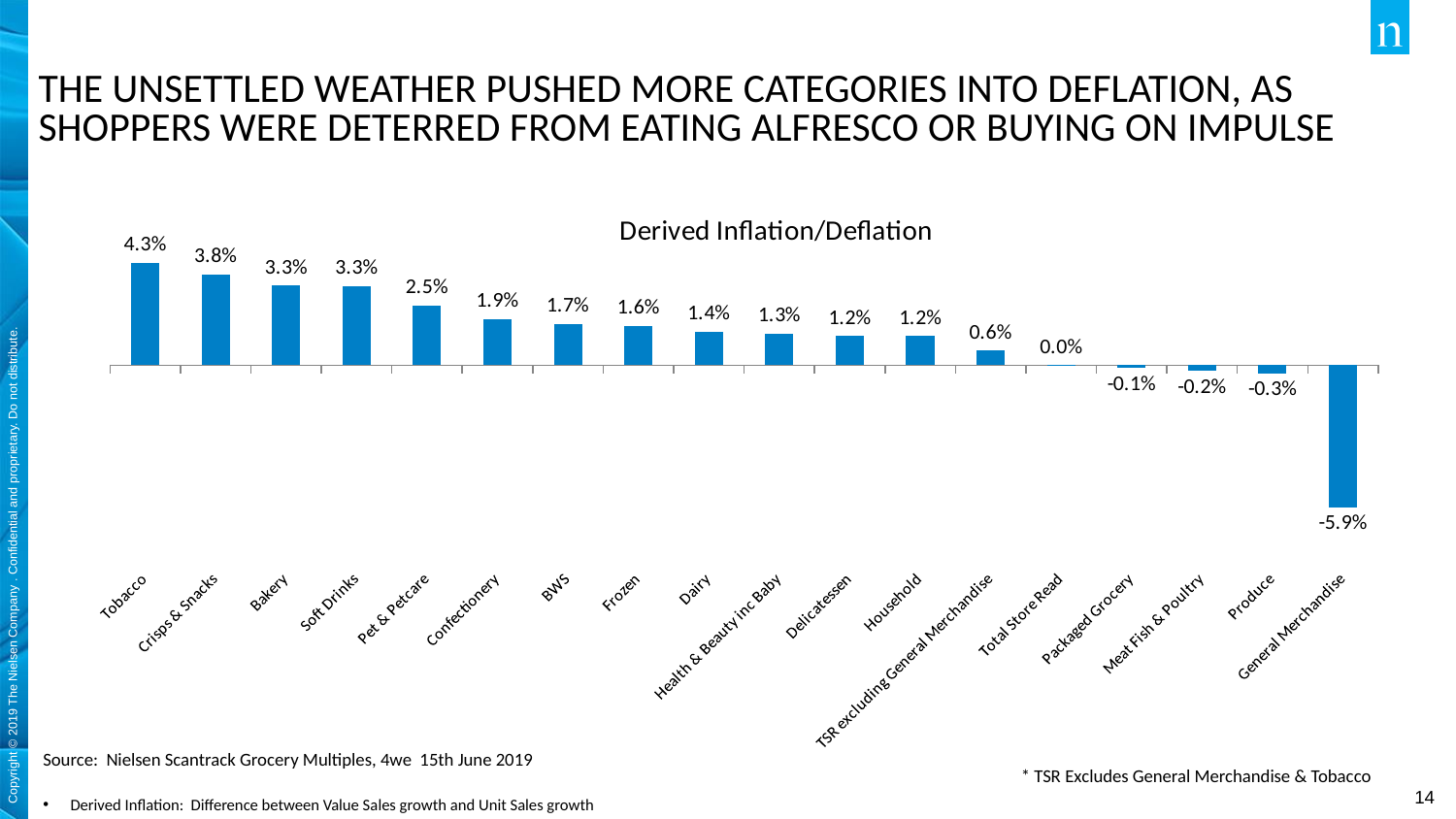
What is the derived inflation value for Tobacco? 4.3% Which category has the lowest derived inflation value? General Merchandise What is the difference between the values for Confectionery and Frozen? 0.3% What is the title of the chart? Derived Inflation/Deflation What is the value shown for Total Store Read? 0.0% Which has a higher value, Dairy or Household? Dairy What is the value shown for Pet & Petcare? 2.5% How many categories are shown in the chart? 18 What is the difference between the values for Tobacco and Crisps & Snacks? 0.5% Which category has the highest derived inflation value? Tobacco What is the value shown for General Merchandise? -5.9% What type of chart is shown on the slide? Bar chart